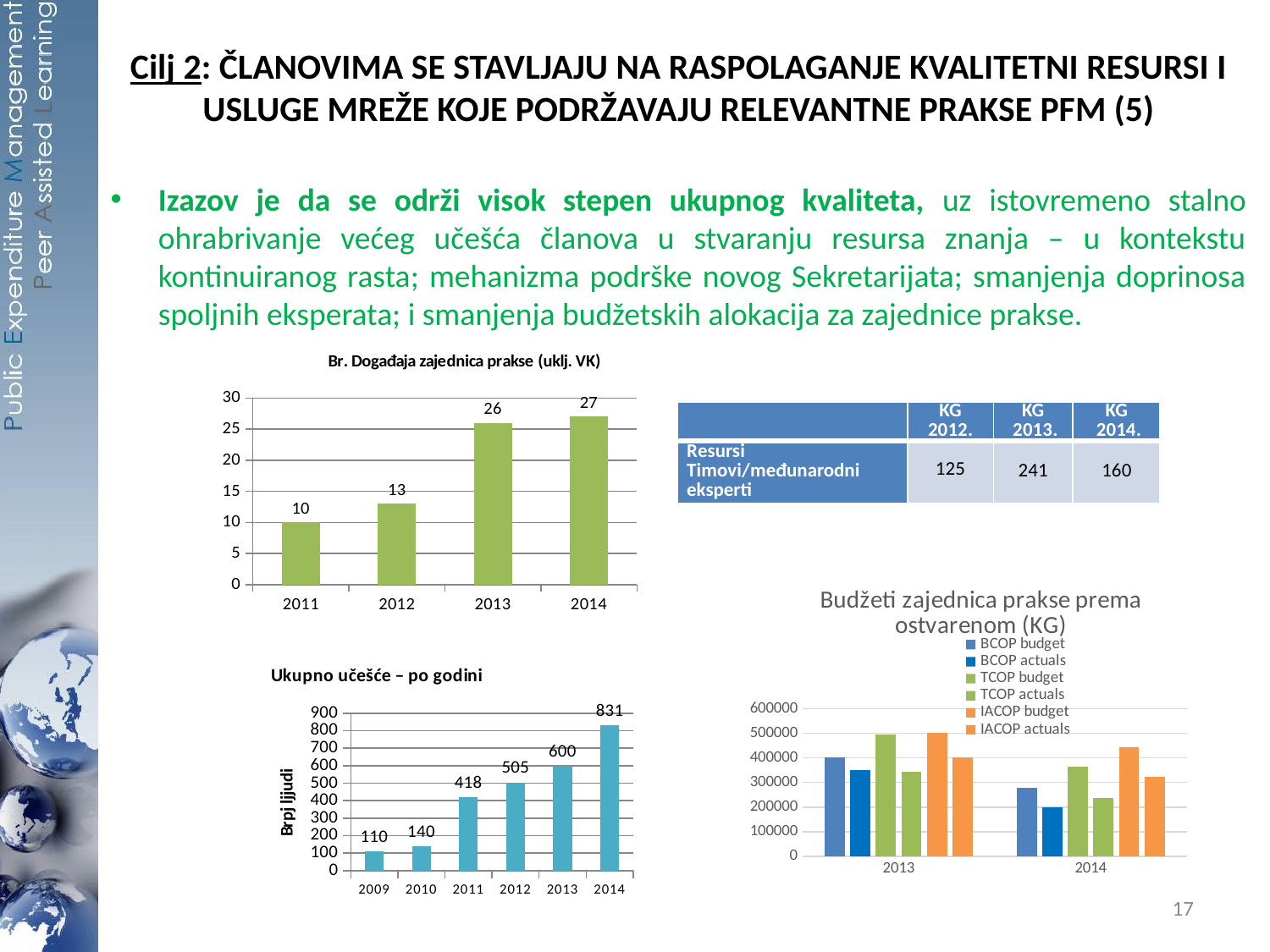
In the chart 'Br. Događaja zajednica prakse (uklj. VK)', how many years are shown on the x axis? 4 In the chart 'Budžeti zajednica prakse prema ostvarenom (KG)', which is larger: IACOP budget in 2013 or IACOP budget in 2014? IACOP budget in 2013 In the chart 'Ukupno učešće – po godini', do the values rise or fall from 2009 to 2014? rise In the chart 'Br. Događaja zajednica prakse (uklj. VK)', which year has the lowest value? 2011 In the chart 'Br. Događaja zajednica prakse (uklj. VK)', what is the difference between the values for 2014 and 2011? 17 In the chart 'Budžeti zajednica prakse prema ostvarenom (KG)', is the value for BCOP actuals in 2014 greater or less than 300000? less In the chart 'Ukupno učešće – po godini', what is the value for 2012? 505 In the chart 'Ukupno učešće – po godini', which year has the highest value? 2014 In the chart 'Ukupno učešće – po godini', what is the difference between the values for 2011 and 2010? 278 In the chart 'Br. Događaja zajednica prakse (uklj. VK)', what is the value for 2013? 26 In the chart 'Budžeti zajednica prakse prema ostvarenom (KG)', how many series does the legend list? 6 In the chart 'Ukupno učešće – po godini', what is the label of the y axis? Brpj ljudi